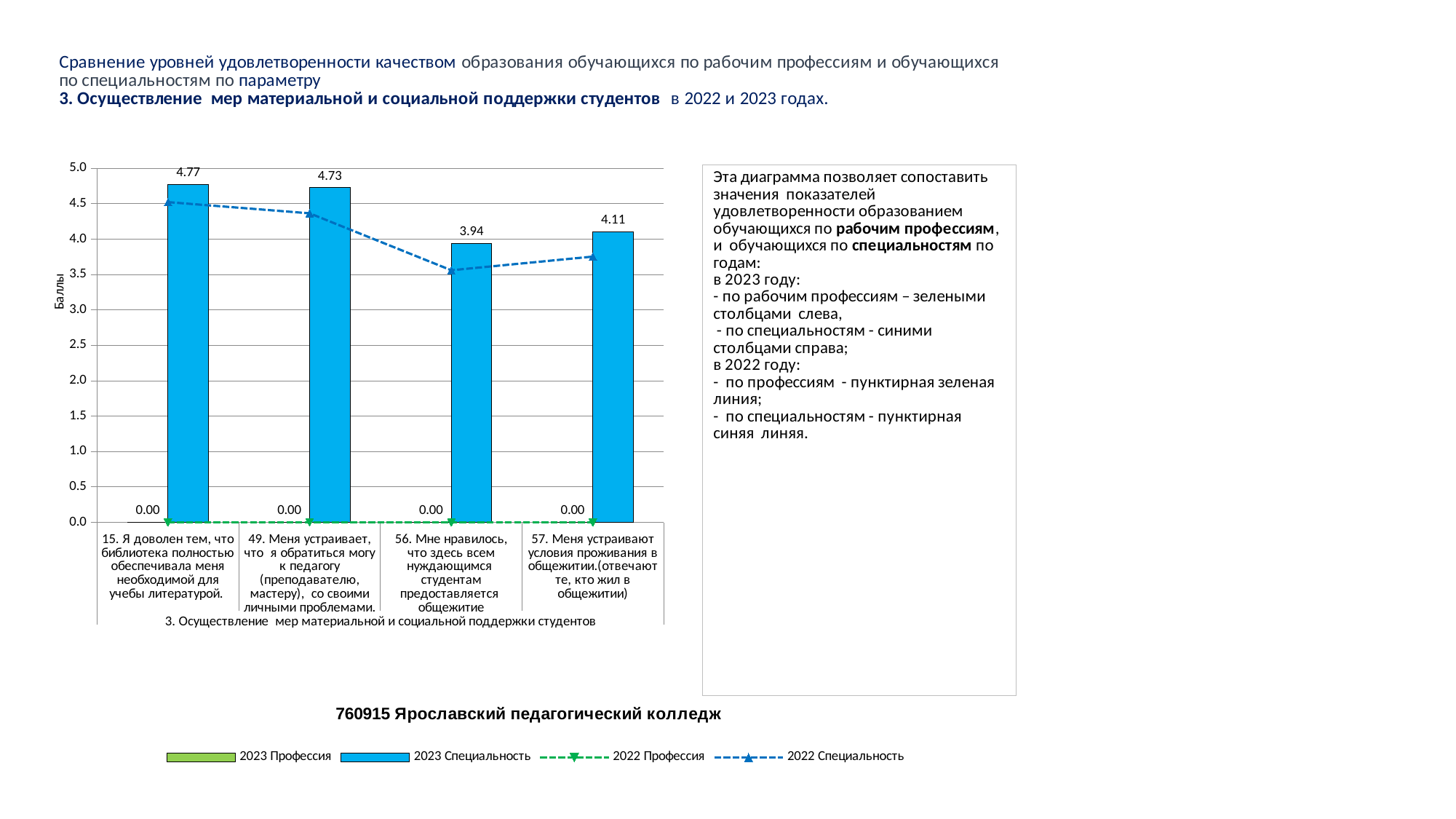
Which category has the highest 2023 Специальность value? 15. Я доволен тем, что библиотека полностью обеспечивала меня необходимой для учебы литературой. What is the value of the 2023 Специальность bar for question 15 (library provided necessary literature)? 4.77 How many series does the chart legend list? 4 Which category has the lowest 2023 Специальность value? 56. Мне нравилось, что здесь всем нуждающимся студентам предоставляется общежитие Which is larger: the 2023 Специальность value for question 49 or for question 57? Question 49 (4.73) What value is labelled for the 2023 Профессия series in every category? 0.00 What is the value of the 2023 Специальность bar for question 57 (satisfied with living conditions in the dormitory)? 4.11 What is the difference between the 2023 Специальность values for question 15 and question 56? 0.83 What is the value of the 2023 Специальность bar for question 56 (dormitory provided to all students in need)? 3.94 How many categories are shown on the x axis of the chart? 4 What is the label of the vertical axis of the chart? Баллы Is the 2022 Специальность value for question 56 greater or less than 4.0? less